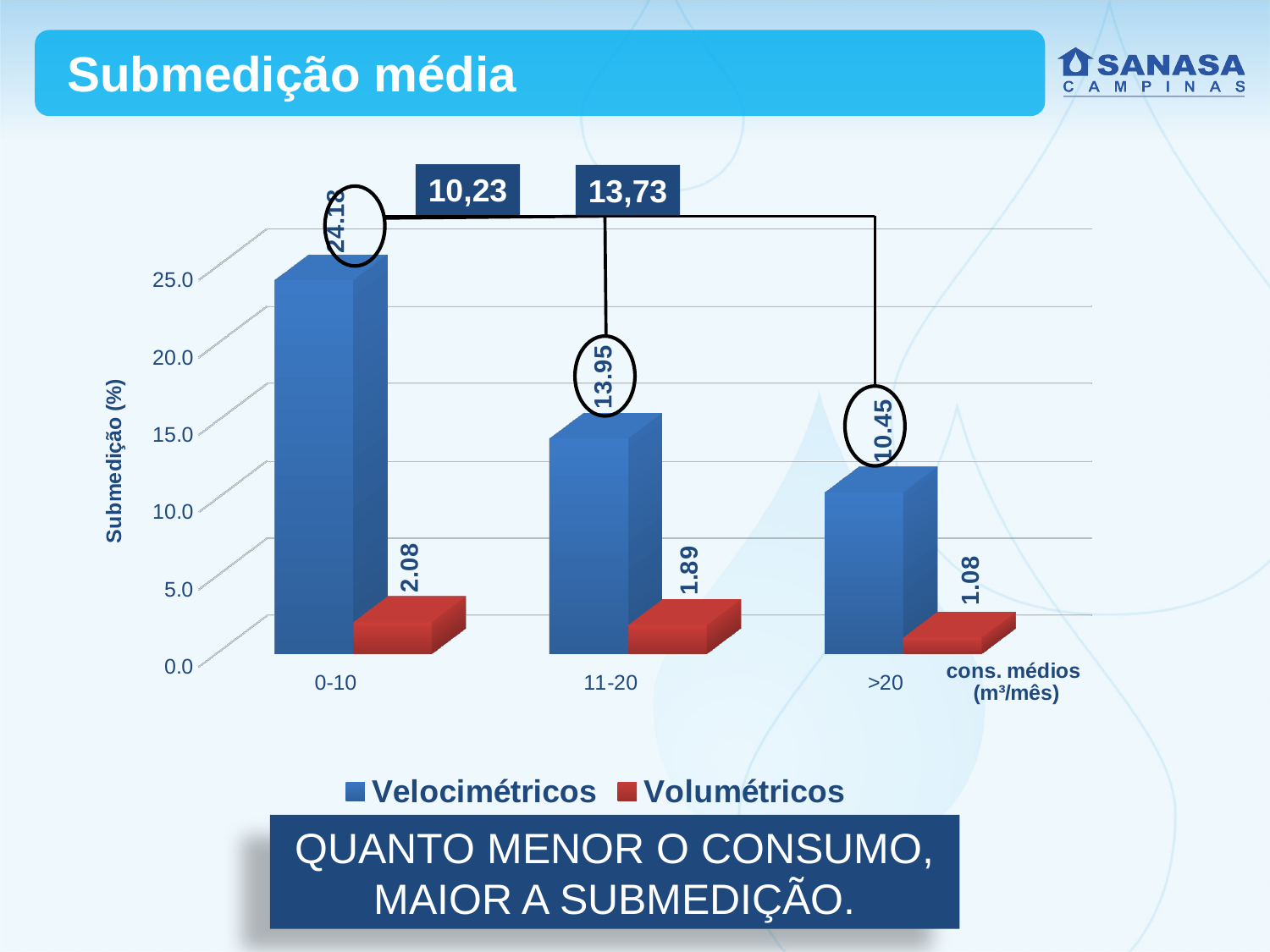
How many series does the legend list? 2 Is the Velocimétricos value for the 0-10 category greater or less than 20.0? greater What type of chart is shown on the slide? bar chart What is the Velocimétricos value for the 11-20 category? 13.95 What is the Velocimétricos value for the >20 category? 10.45 What is the Volumétricos value for the >20 category? 1.08 What is the Volumétricos value for the 0-10 category? 2.08 What is the difference between the Velocimétricos values for 11-20 and >20? 3.50 Do the Velocimétricos values rise or fall as consumption increases along the x axis? fall Which category has the lowest Volumétricos value? >20 Which category has the highest Velocimétricos value? 0-10 How many consumption categories are shown on the x axis? 3